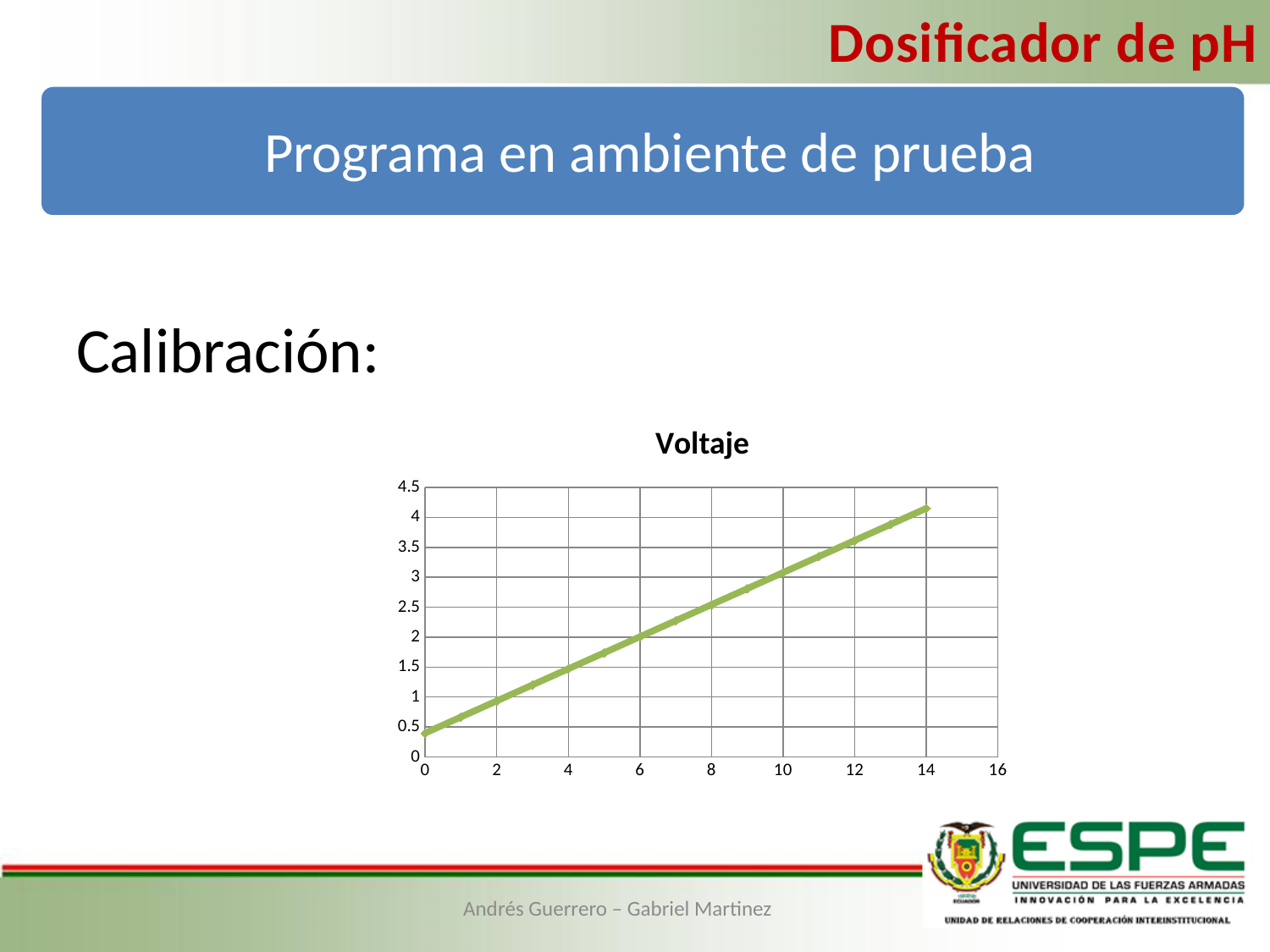
Is the value at x = 6 greater or less than 2.5? less Which is larger, the value at x = 14 or the value at x = 0? the value at x = 14 Is the value at x = 12 greater or less than 3? greater Is the value at x = 0 greater or less than 1? less Do the values rise or fall as the x axis increases? rise What kind of chart is shown on the slide? line chart What is the highest tick shown on the y axis? 4.5 What is the title of the chart? Voltaje